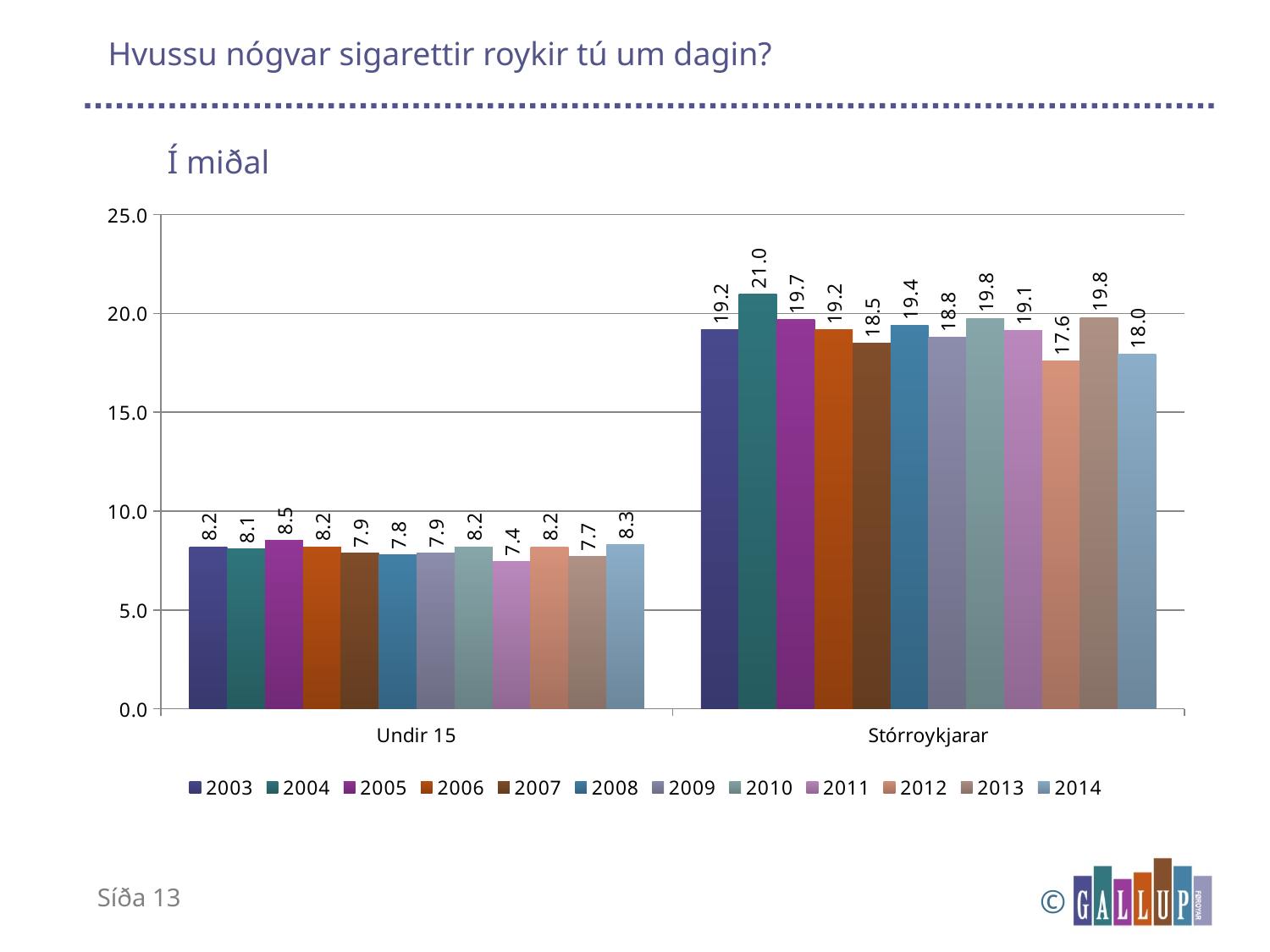
How many series does the legend list? 12 What is the difference between the 2004 and 2012 values in the Stórroykjarar category? 3.4 What is the value for 2004 in the Stórroykjarar category? 21.0 Which year has the lowest value in the Stórroykjarar category? 2012 Which year has the highest value in the Stórroykjarar category? 2004 How many categories are shown on the x axis? 2 Is the value for 2007 in the Stórroykjarar category greater or less than 20.0? less Which is larger in the Undir 15 category, the value for 2005 or the value for 2008? 2005 Which year has the lowest value in the Undir 15 category? 2011 What is the value for 2011 in the Undir 15 category? 7.4 What is the value for 2014 in the Stórroykjarar category? 18.0 What kind of chart is shown on the slide? bar chart